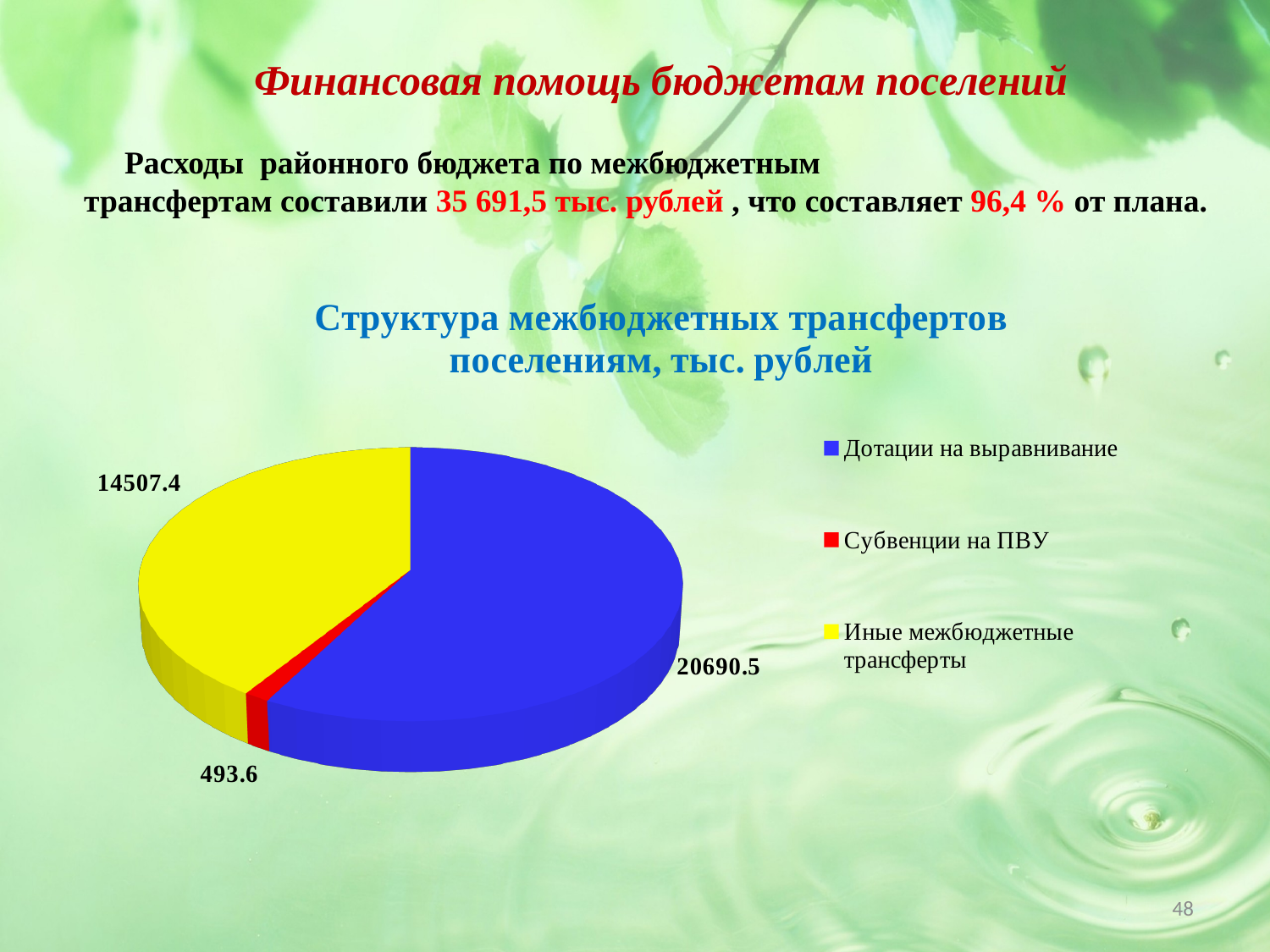
Which category has the smallest slice in the pie chart? Субвенции на ПВУ What colour is the slice for Субвенции на ПВУ? Red Which is larger: Дотации на выравнивание or Иные межбюджетные трансферты? Дотации на выравнивание What is the difference between the values for Иные межбюджетные трансферты and Субвенции на ПВУ? 14013.8 Which category has the largest slice in the pie chart? Дотации на выравнивание What is the value for Субвенции на ПВУ in the pie chart? 493.6 What is the value for Иные межбюджетные трансферты in the pie chart? 14507.4 How many slices does the pie chart have? 3 What kind of chart is shown on the slide? Pie chart How many entries does the legend of the pie chart list? 3 What is the difference between the values for Дотации на выравнивание and Иные межбюджетные трансферты? 6183.1 What is the value for Дотации на выравнивание in the pie chart? 20690.5